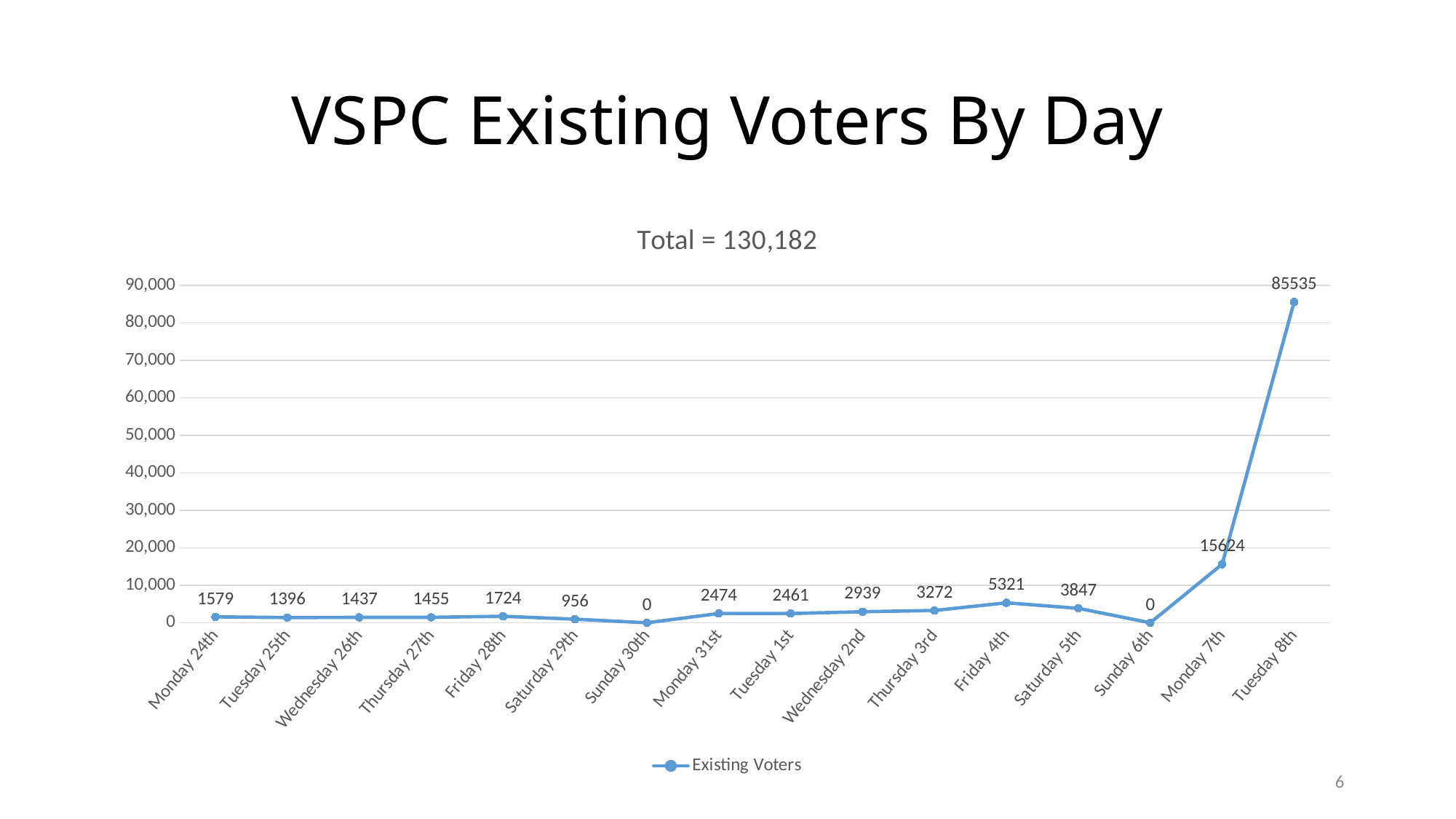
What is the value for Existing Voters on Monday 7th? 15624 How many days are plotted on the x axis? 16 What is the value for Existing Voters on Friday 4th? 5321 What is the difference in Existing Voters between Friday 4th and Saturday 5th? 1474 What kind of chart is shown on the slide? line chart Which is larger, the value for Monday 24th or the value for Tuesday 25th? Monday 24th What total is stated in the chart's subtitle? Total = 130,182 What is the value for Existing Voters on Tuesday 8th? 85535 Which day has the highest number of Existing Voters? Tuesday 8th What is the value for Existing Voters on Saturday 29th? 956 What is the difference in Existing Voters between Tuesday 8th and Monday 7th? 69911 Is the value for Monday 7th greater or less than 10,000? greater